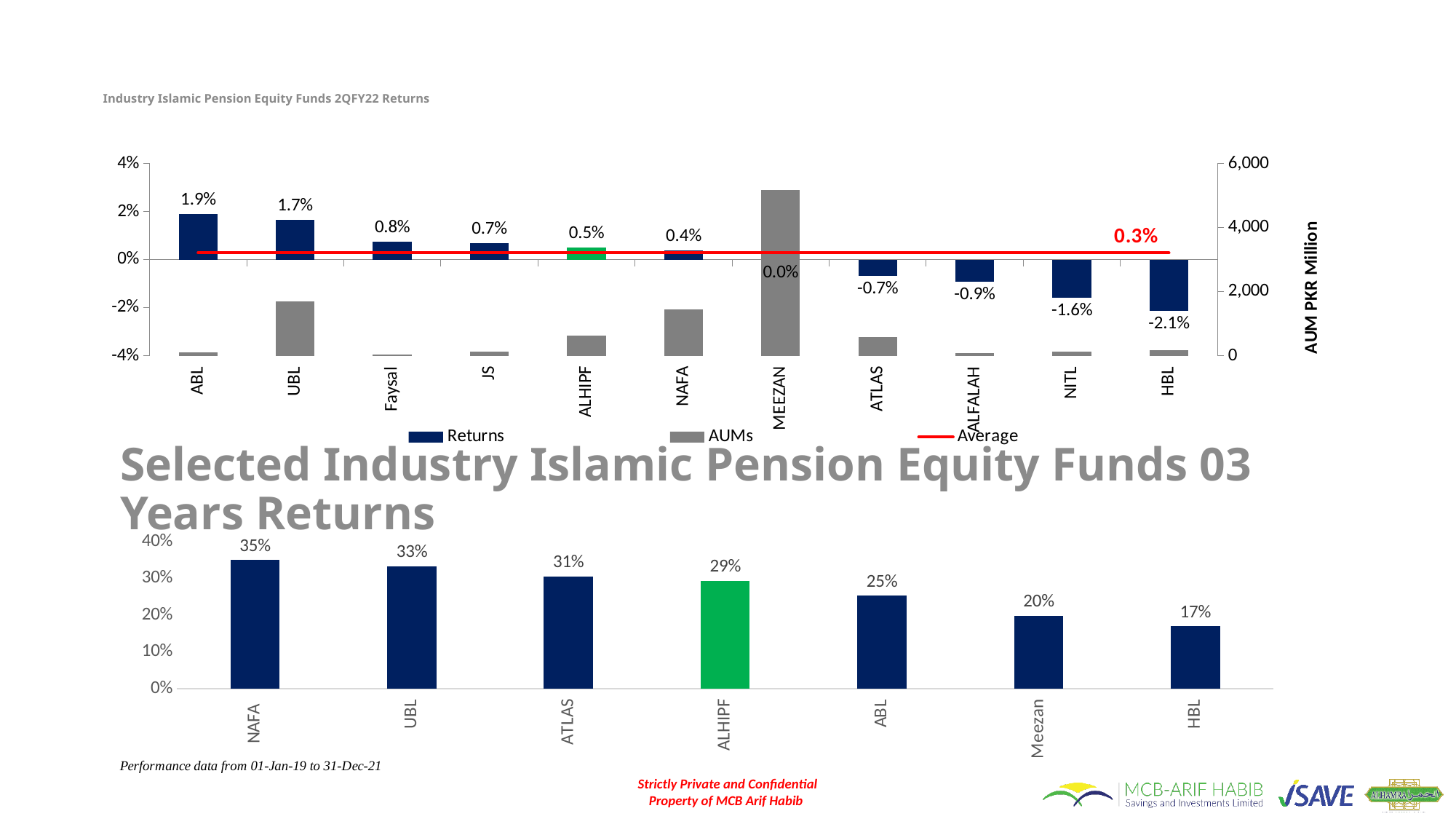
In the bottom chart (03 Years Returns), what is the difference between the returns of NAFA and HBL? 18% In the top chart (Industry Islamic Pension Equity Funds 2QFY22 Returns), what is the return for ABL? 1.9% In the top chart (2QFY22 Returns), is the AUM for MEEZAN greater or less than 4,000 PKR million? greater In the bottom chart (03 Years Returns), do the values rise or fall from left to right along the x axis? fall In the top chart (2QFY22 Returns), what is the average return shown by the red line? 0.3% In the bottom chart (03 Years Returns), which fund has the highest return? NAFA In the top chart (2QFY22 Returns), what is the return for NITL? -1.6% In the bottom chart (Selected Industry Islamic Pension Equity Funds 03 Years Returns), what is the 3-year return for ATLAS? 31% In the top chart (2QFY22 Returns), how many series does the legend list? 3 In the top chart (2QFY22 Returns), what is the difference between the returns of ABL and UBL? 0.2% In the top chart (2QFY22 Returns), how many funds are shown on the x axis? 11 In the top chart (2QFY22 Returns), which fund has the lowest return? HBL